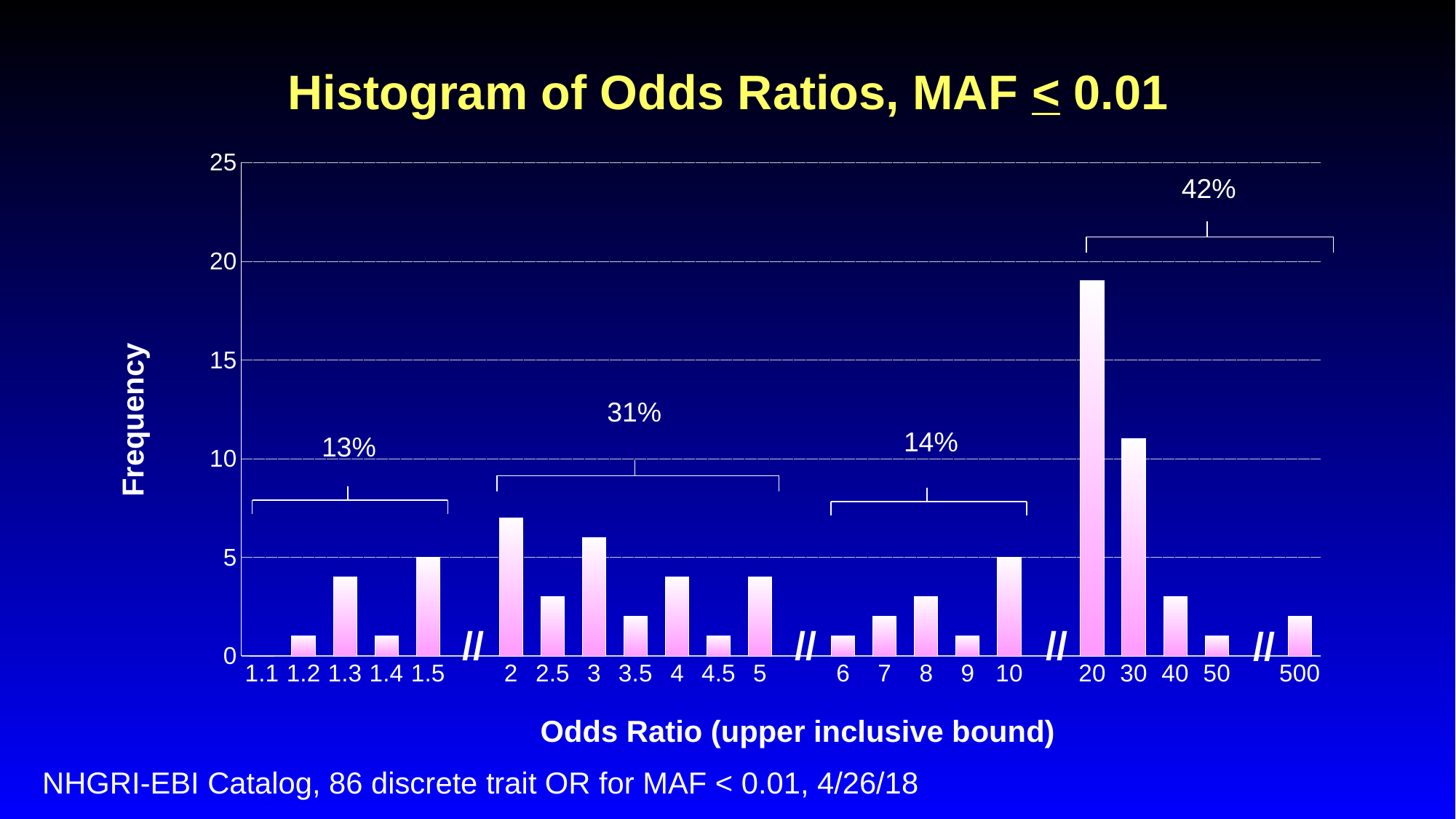
Is the frequency for the odds ratio category 30 greater or less than 10? greater Is the frequency for the odds ratio category 2 greater or less than 5? greater What is the frequency for the odds ratio category 10? 5 Which odds ratio category has the highest frequency? 20 Which has a higher frequency, the odds ratio category 2 or 2.5? 2 What is the frequency for the odds ratio category 1.5? 5 What kind of chart is shown on the slide? bar chart What percentage is printed above the group of bars from 20 to 500? 42% Which has a higher frequency, the odds ratio category 20 or 30? 20 Is the frequency for the odds ratio category 20 greater or less than 15? greater How many odds ratio categories are shown on the x axis? 22